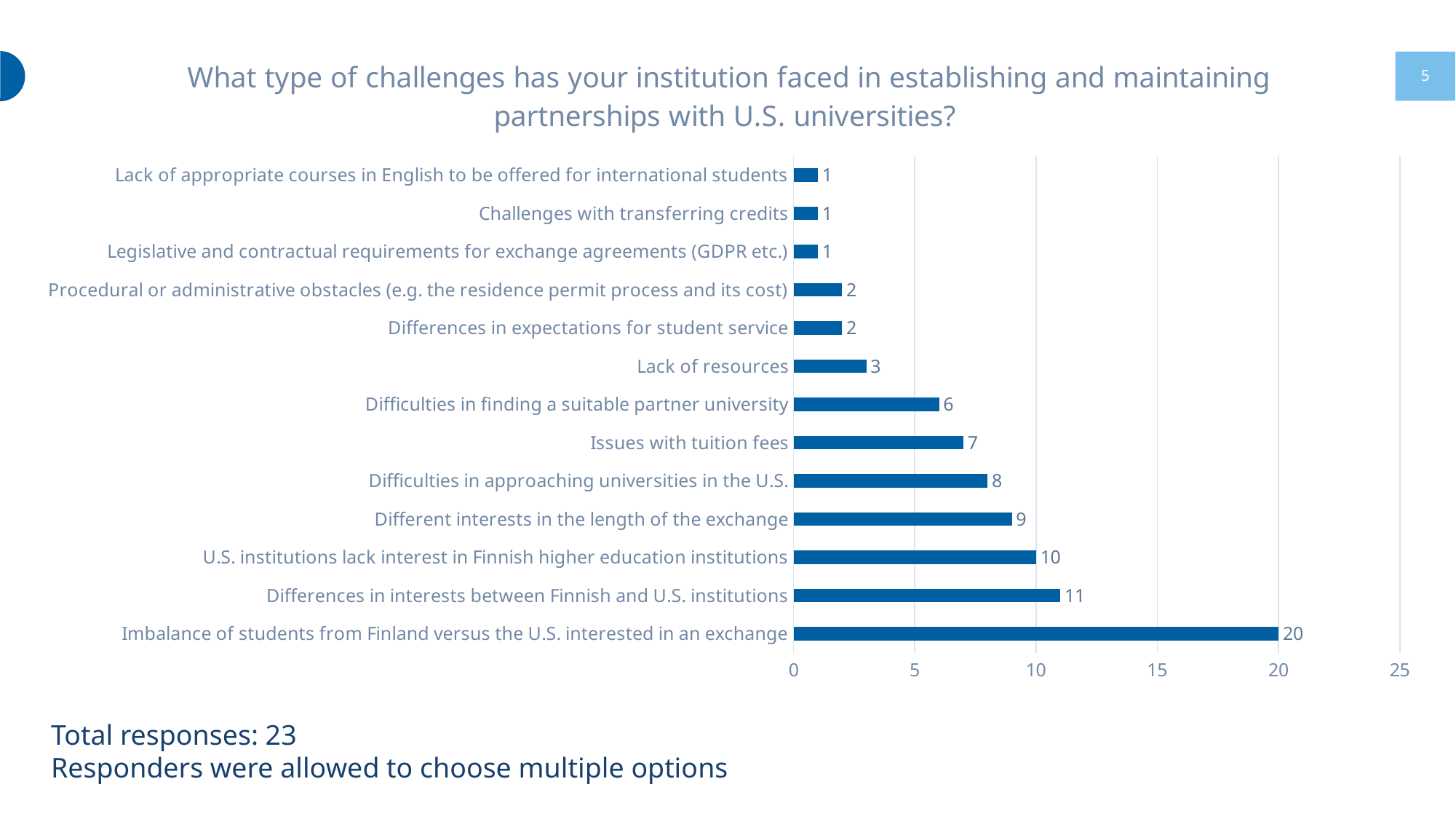
What is the difference between the values for "Different interests in the length of the exchange" and "Difficulties in finding a suitable partner university"? 3 What value is shown for "Issues with tuition fees"? 7 What value is shown for "U.S. institutions lack interest in Finnish higher education institutions"? 10 What is the maximum value shown on the horizontal axis? 25 What value is shown for "Lack of resources"? 3 How many categories have a value of 1? 3 Is the value for "Differences in interests between Finnish and U.S. institutions" greater or less than 10? greater Which is larger: the value for "Difficulties in approaching universities in the U.S." or the value for "Issues with tuition fees"? Difficulties in approaching universities in the U.S. How many categories are shown in the chart? 13 What is the difference between the values for "Imbalance of students from Finland versus the U.S. interested in an exchange" and "Differences in interests between Finnish and U.S. institutions"? 9 Which category has the highest value? Imbalance of students from Finland versus the U.S. interested in an exchange What kind of chart is shown on the slide? bar chart